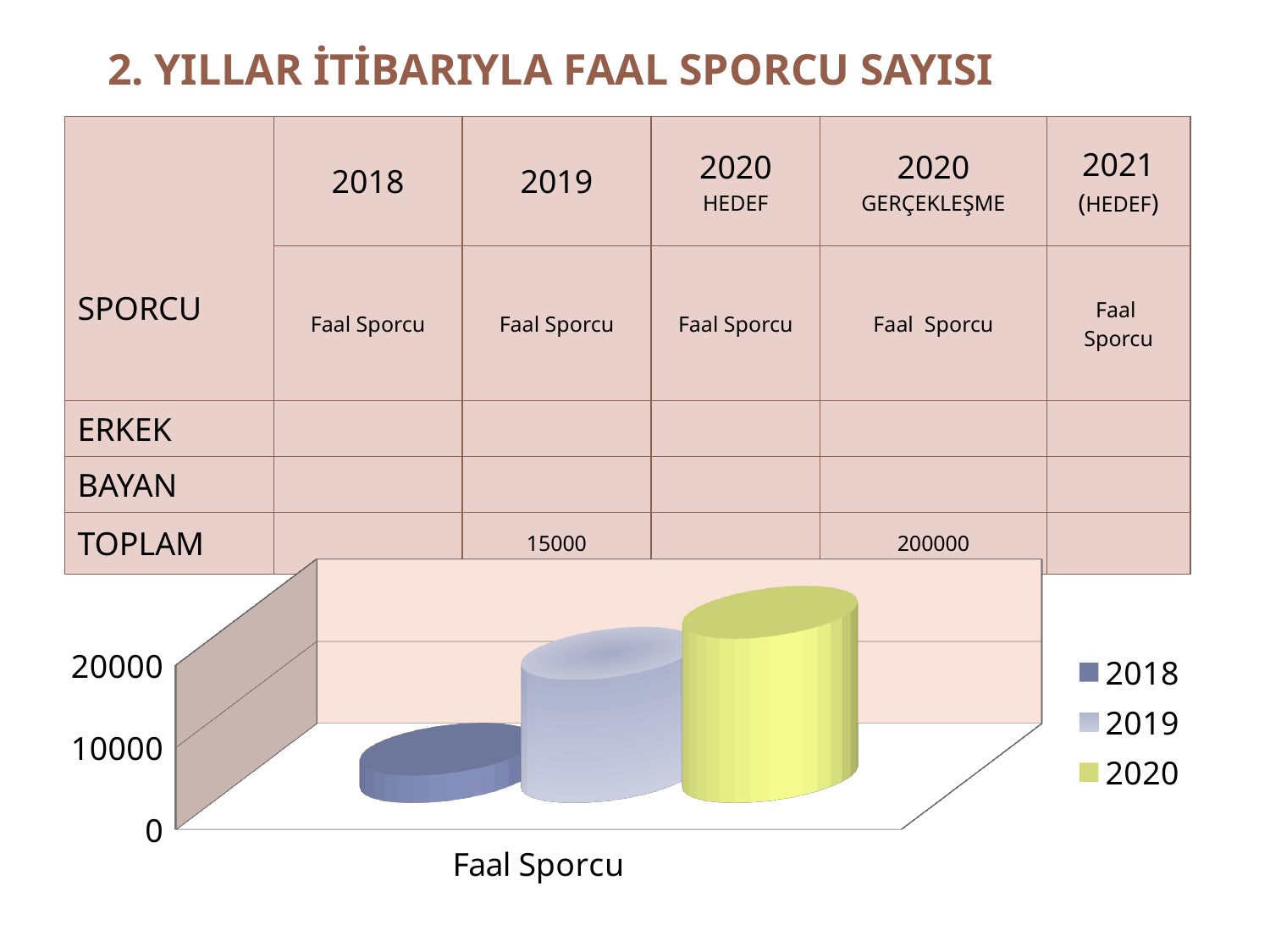
Which bar is taller, 2018 or 2019? 2019 What kind of chart is shown on the slide? bar chart Which years are listed in the chart legend? 2018, 2019, 2020 Which series has the lowest bar in the chart? 2018 Is the bar for 2020 greater or less than 10000? greater Which series has the highest bar in the chart? 2020 Is the bar for 2019 greater or less than 10000? greater What is the category label shown on the x axis of the chart? Faal Sporcu How many categories are shown on the x axis of the chart? 1 How many series does the chart legend list? 3 Do the bars rise or fall from 2018 to 2020? rise Is the bar for 2018 greater or less than 10000? less